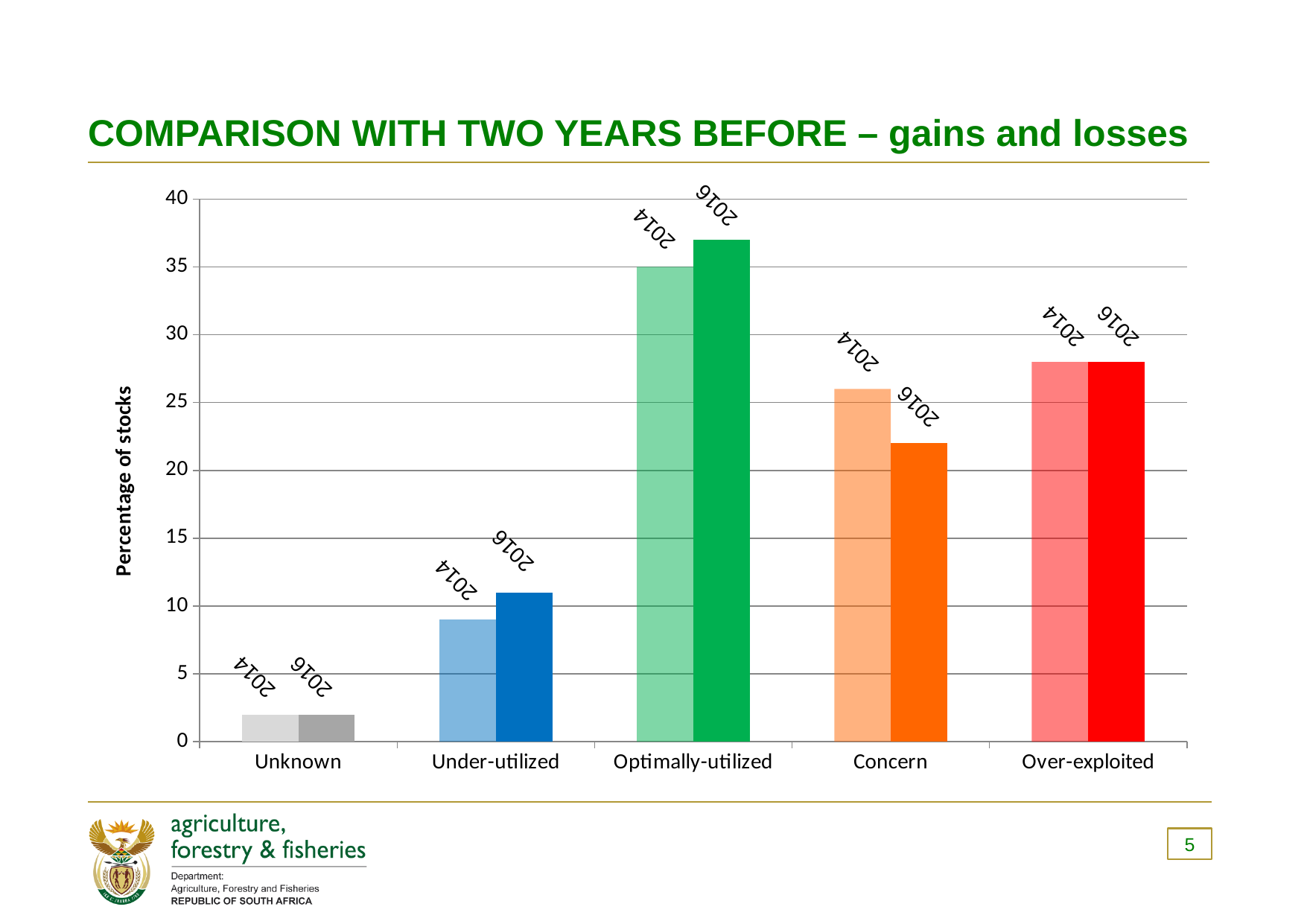
What kind of chart is shown on the slide? bar chart Is the value for Under-utilized in 2016 greater or less than 10? greater Is the value for Over-exploited in 2014 greater or less than 25? greater How many categories are shown on the x axis of the chart? 5 What is the value for Optimally-utilized in 2014? 35 For Under-utilized, which year has the larger value, 2014 or 2016? 2016 Which two years are compared in the chart? 2014 and 2016 Which category has the lowest bars in the chart? Unknown For Concern, which year has the larger value, 2014 or 2016? 2014 Which category has the highest bar in the chart? Optimally-utilized What is the label of the vertical axis? Percentage of stocks Is the value for Concern in 2016 greater or less than 25? less